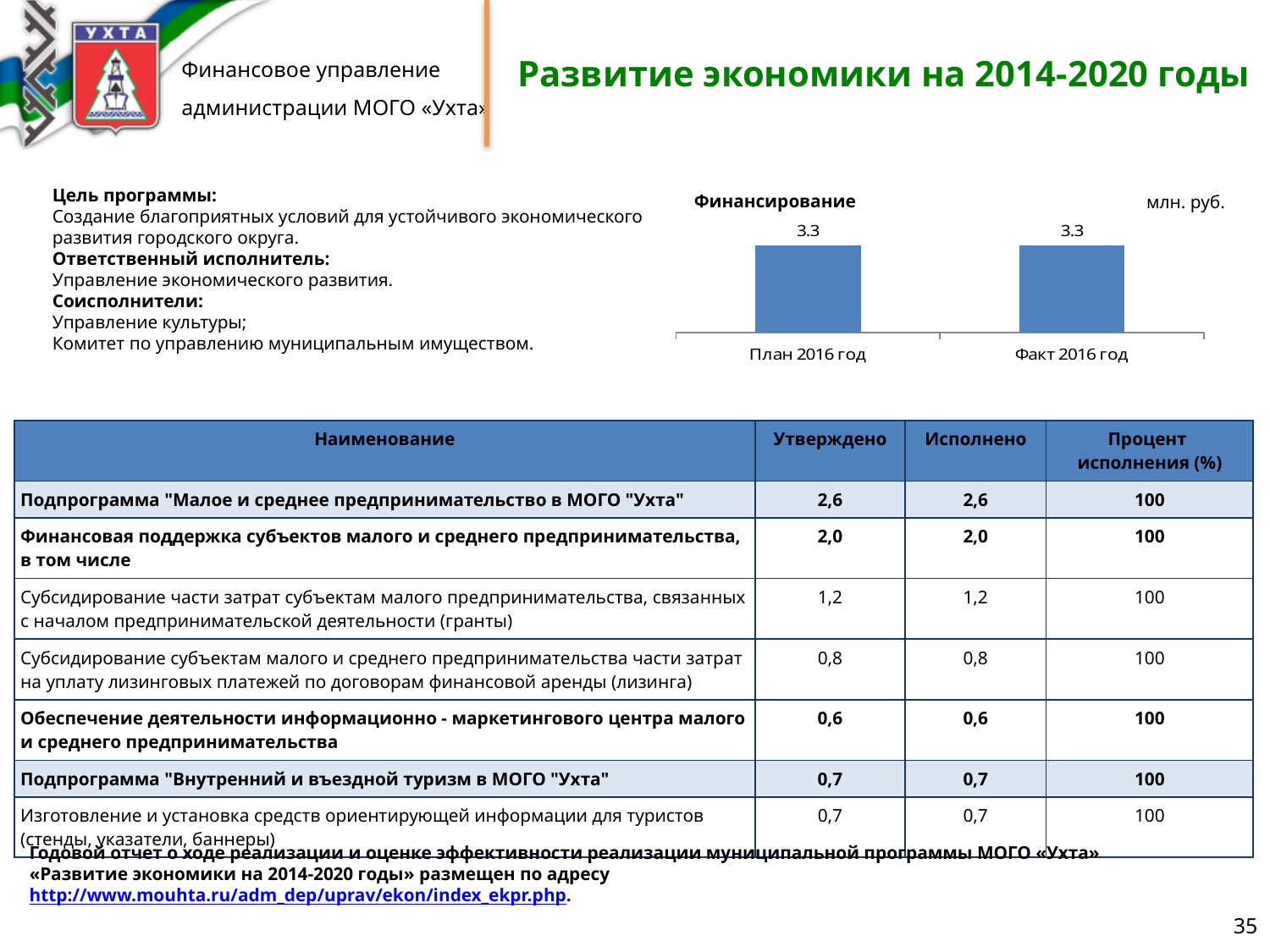
What is the value for Факт 2016 год in the Финансирование chart? 3.3 What is the value for План 2016 год in the Финансирование chart? 3.3 What is the difference between the План 2016 год and Факт 2016 год values in the Финансирование chart? 0 What kind of chart is the Финансирование chart? bar chart What are the two category labels on the x axis of the Финансирование chart? План 2016 год and Факт 2016 год In the Финансирование chart, is the value for Факт 2016 год larger than, smaller than, or equal to the value for План 2016 год? equal What unit is indicated for the values in the Финансирование chart? млн. руб. How many bars are shown in the Финансирование chart? 2 What is the title of the chart on the slide? Финансирование